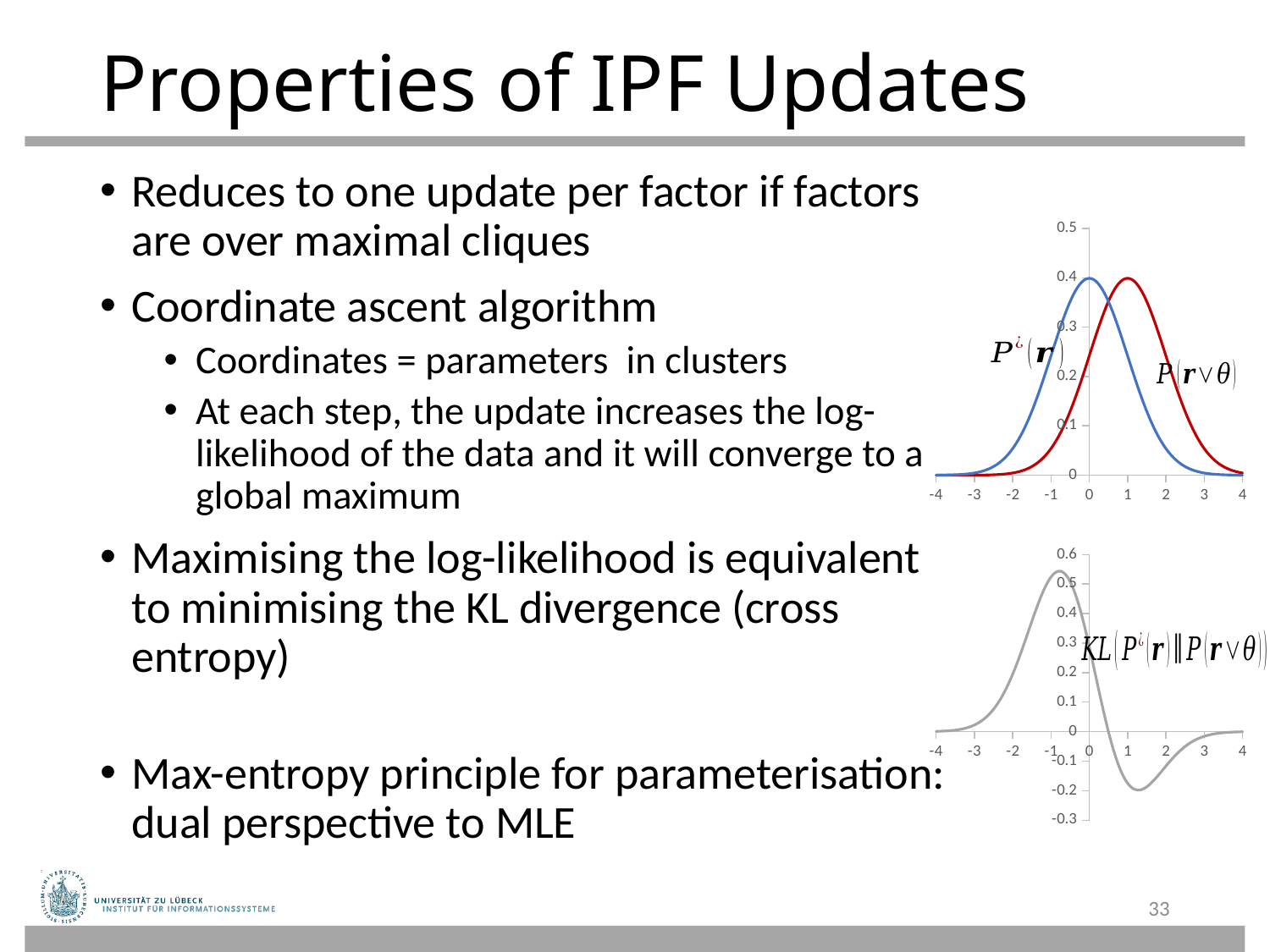
In the top chart, is the value of the blue curve at x = 2 greater or less than 0.1? less What is the highest tick value shown on the y axis of the bottom chart? 0.6 In the top chart, at x = -1, which curve has the larger value, the red curve or the blue curve? blue curve How many curves are plotted in the top chart? 2 How many curves are plotted in the bottom chart? 1 In the top chart, is the value of the red curve at x = -1 greater or less than 0.1? less In the top chart, at x = 2, which curve has the larger value, the red curve or the blue curve? red curve What kind of chart is the top chart on the slide? line chart In the bottom chart, is the maximum value of the gray curve greater or less than 0.4? greater What kind of chart is the bottom chart on the slide? line chart